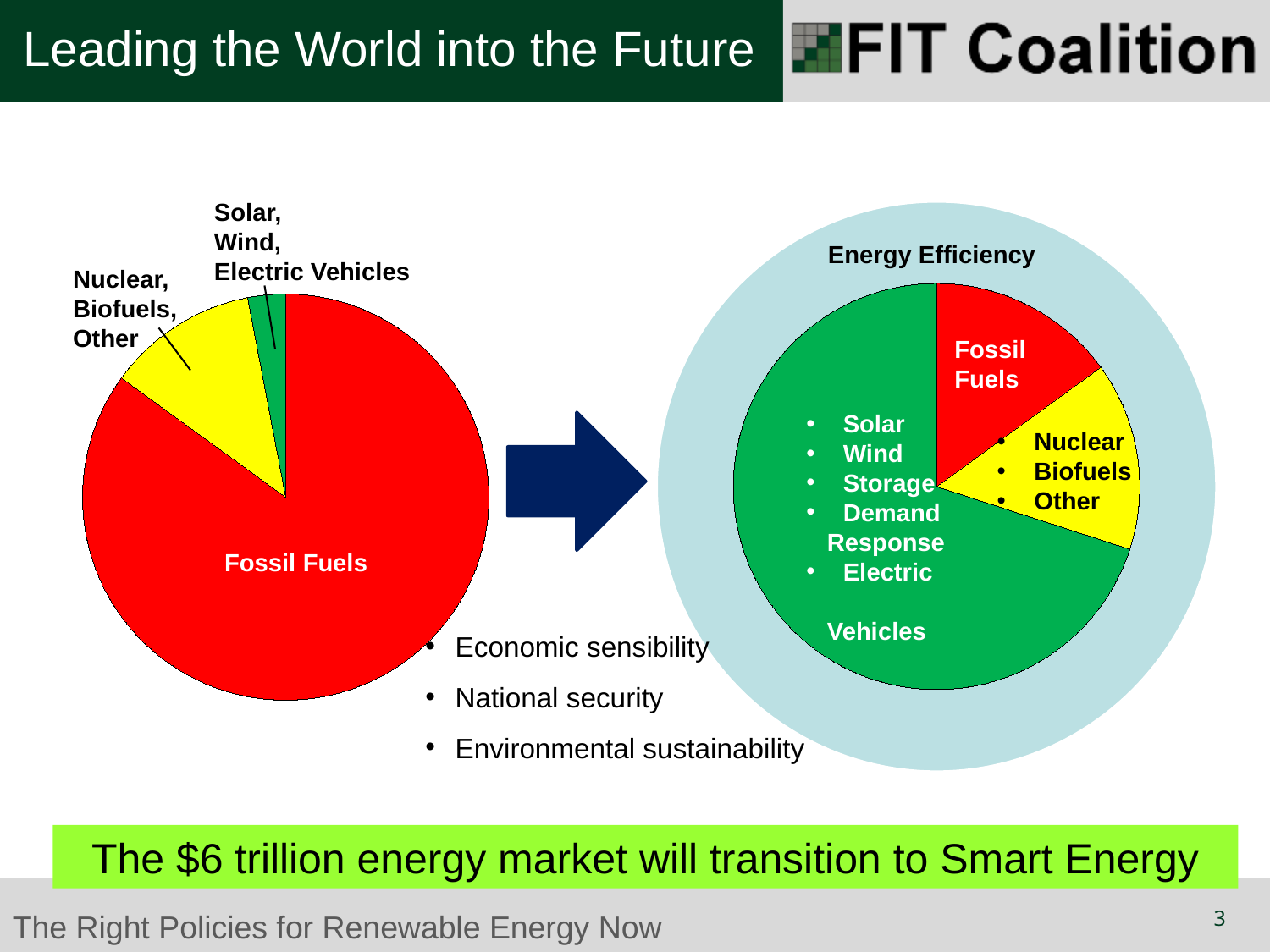
What kind of chart is the right chart on the slide? Pie chart In the right pie chart, which slice is larger: Fossil Fuels or the Solar, Wind, Storage, Demand Response, Electric Vehicles slice? Solar, Wind, Storage, Demand Response, Electric Vehicles What kind of chart is the left chart on the slide? Pie chart In the left pie chart, which slice is the largest? Fossil Fuels In the left pie chart, which slice is larger: Nuclear, Biofuels, Other or Solar, Wind, Electric Vehicles? Nuclear, Biofuels, Other How many slices does the left pie chart have? 3 What label appears on the light blue ring surrounding the right pie chart? Energy Efficiency In the left pie chart, which slice is the smallest? Solar, Wind, Electric Vehicles What colour is the Fossil Fuels slice in both pie charts? Red In the left pie chart, which slice is larger: Fossil Fuels or Nuclear, Biofuels, Other? Fossil Fuels In the right pie chart, which slice is the largest? Solar, Wind, Storage, Demand Response, Electric Vehicles How many slices does the right pie chart have? 3